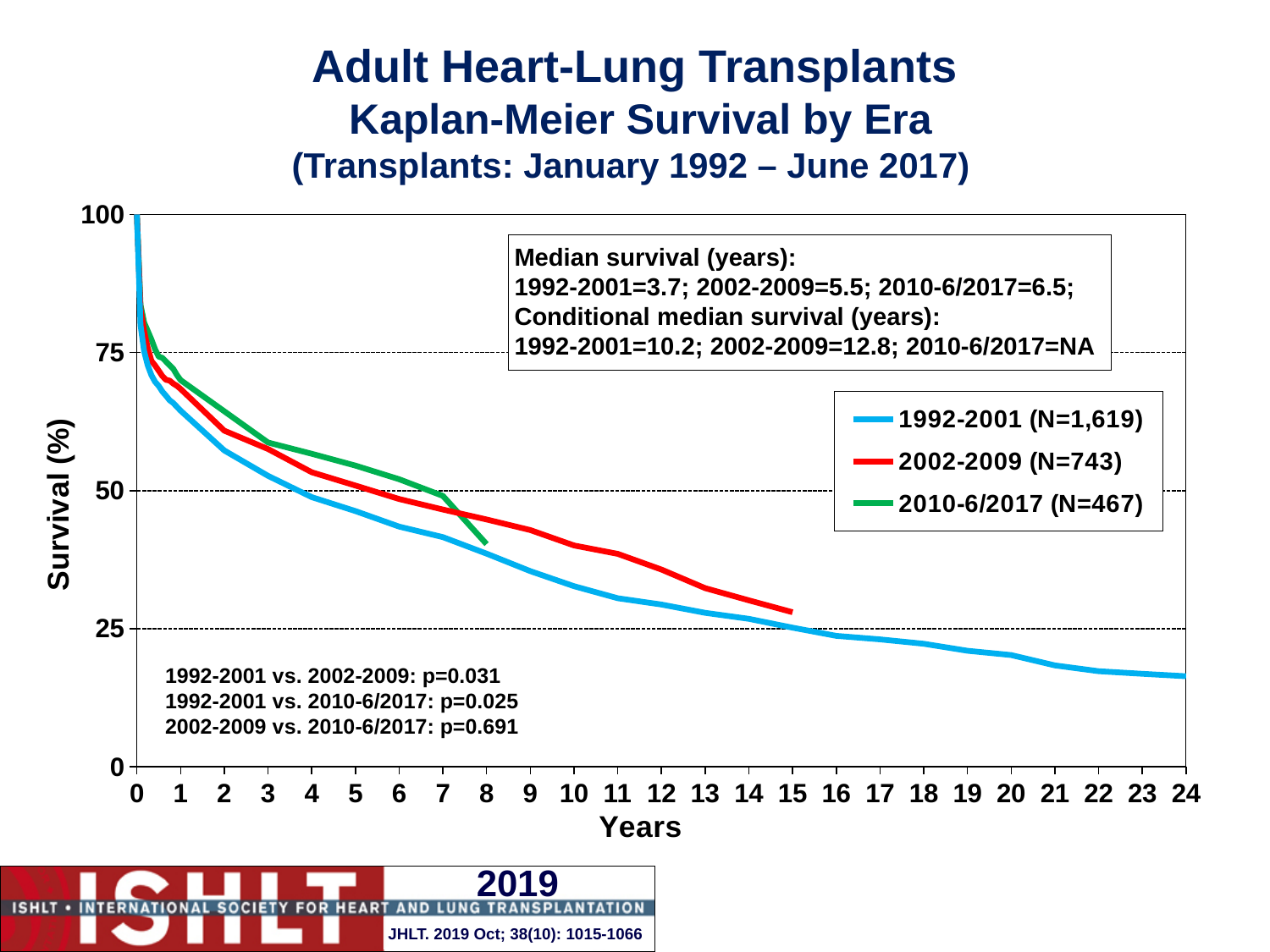
How many series does the legend list? 3 Is the survival value for the 1992-2001 series at 10 years greater or less than 25? greater Which era has the highest median survival? 2010-6/2017 What is the conditional median survival in years for the 2002-2009 era? 12.8 Do the survival curves rise or fall as years increase? fall Is the survival value for the 1992-2001 series at 20 years greater or less than 25? less What is the difference in median survival (years) between the 2010-6/2017 era and the 1992-2001 era? 2.8 Is the survival value for the 2010-6/2017 series at 5 years greater or less than 50? greater At 5 years, which series has higher survival, 1992-2001 or 2002-2009? 2002-2009 What is the median survival in years for the 1992-2001 era? 3.7 What is the median survival in years for the 2002-2009 era? 5.5 What kind of chart is shown on the slide? line chart